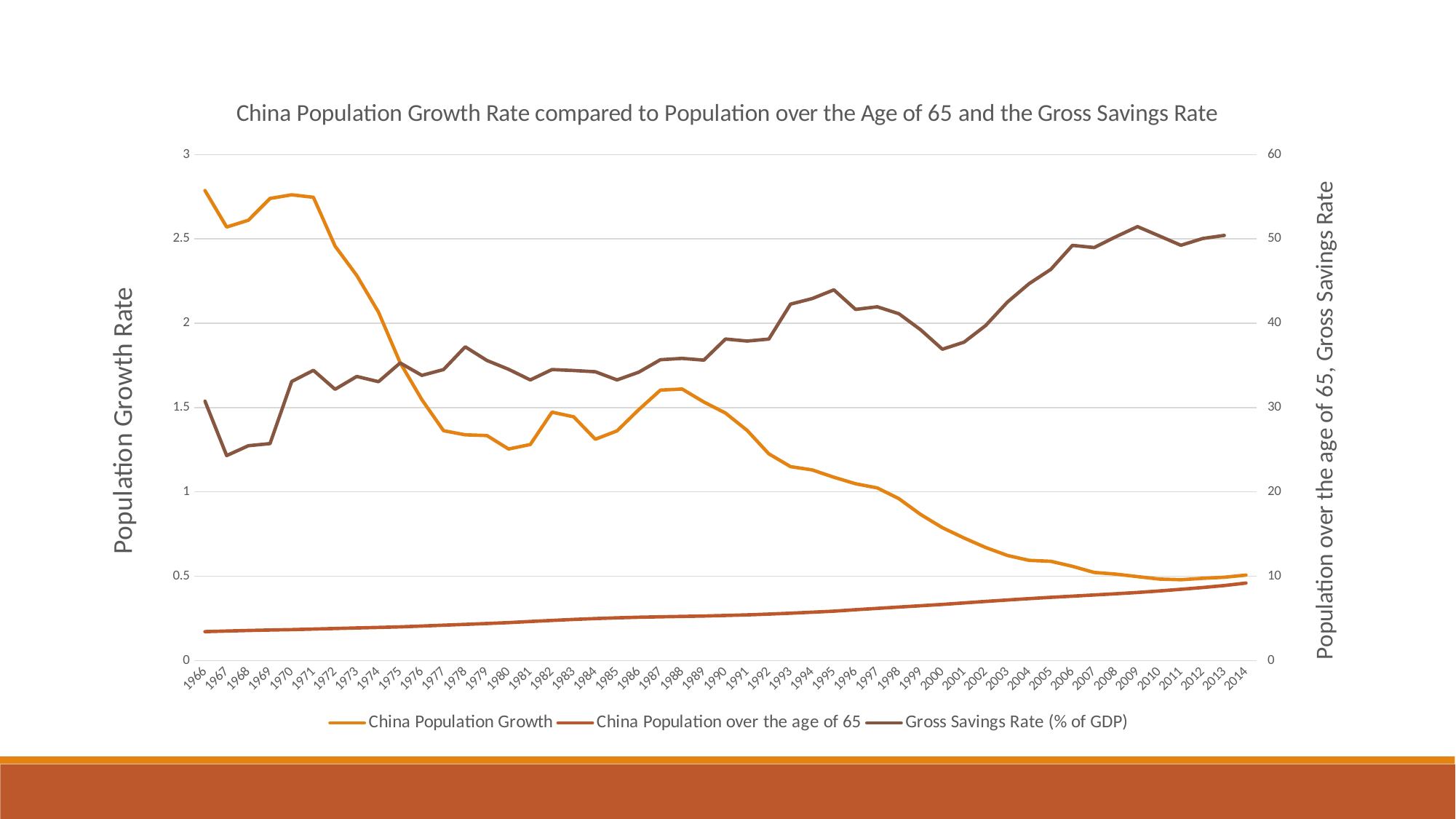
Is the Gross Savings Rate (% of GDP) in 2009 greater or less than 40? greater How many series does the legend list? 3 Is the value for China Population Growth in 1966 greater or less than 2.5? greater What is the title of the right-hand vertical axis? Population over the age of 65, Gross Savings Rate What kind of chart is shown on the slide? line chart How many years are plotted along the x axis? 49 Is the Gross Savings Rate (% of GDP) in 1967 greater or less than 30? less Does the China Population over the age of 65 series rise or fall overall from 1966 to 2014? rise Does the China Population Growth series rise or fall overall from 1966 to 2014? fall In which year is the Gross Savings Rate (% of GDP) lowest? 1967 In which year is China Population over the age of 65 highest? 2014